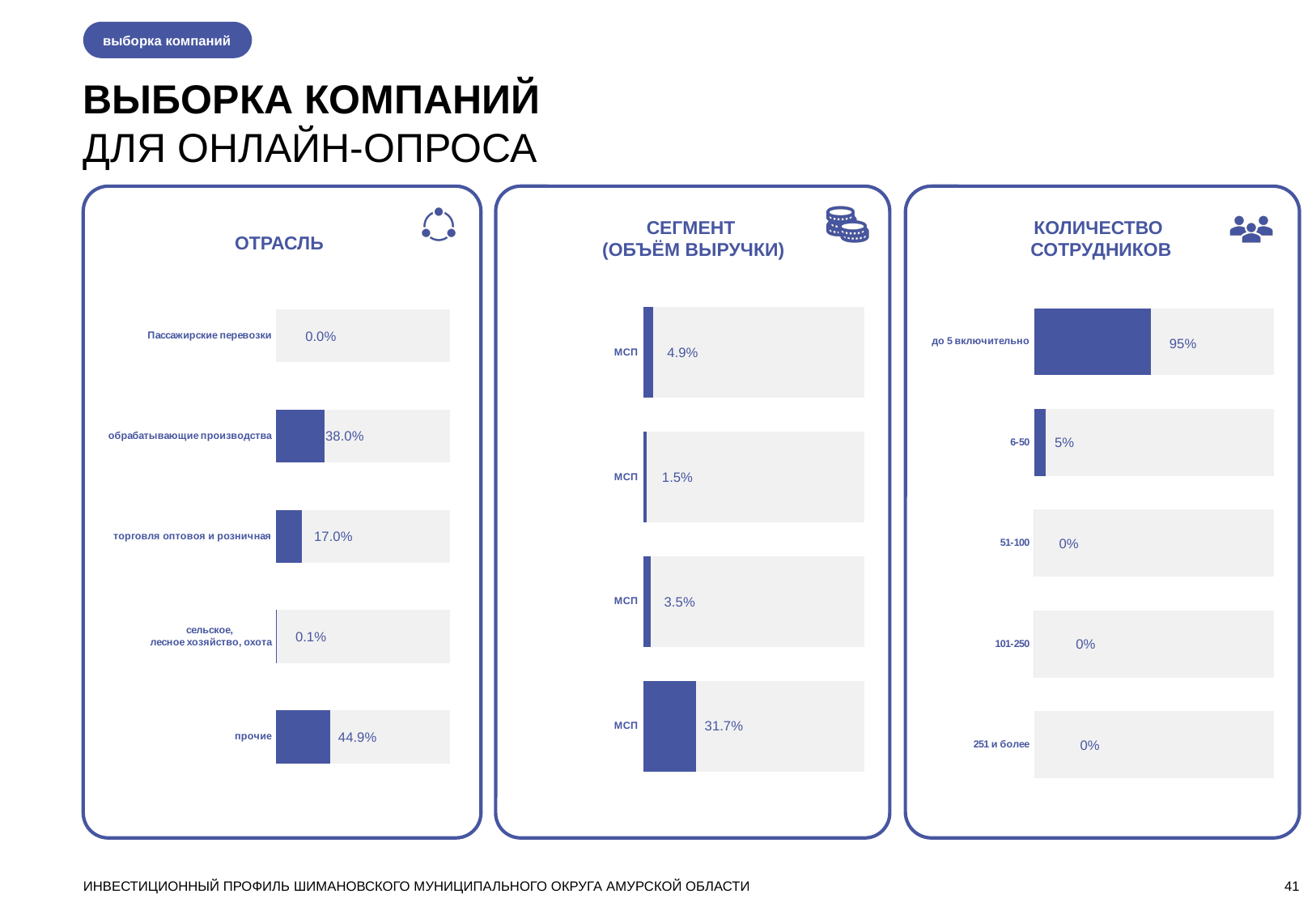
In the "КОЛИЧЕСТВО СОТРУДНИКОВ" chart, what is the value for "до 5 включительно"? 95% What kind of chart is the "КОЛИЧЕСТВО СОТРУДНИКОВ" chart? bar chart In the "СЕГМЕНТ (ОБЪЁМ ВЫРУЧКИ)" chart, what is the value of the bottom bar? 31.7% In the "КОЛИЧЕСТВО СОТРУДНИКОВ" chart, which is larger: the value for "6-50" or the value for "51-100"? 6-50 In the "ОТРАСЛЬ" chart, which category has the highest value? прочие In the "ОТРАСЛЬ" chart, what is the value for "торговля оптовая и розничная"? 17.0% How many bars are shown in the "СЕГМЕНТ (ОБЪЁМ ВЫРУЧКИ)" chart? 4 In the "ОТРАСЛЬ" chart, what is the value for "обрабатывающие производства"? 38.0% In the "СЕГМЕНТ (ОБЪЁМ ВЫРУЧКИ)" chart, what is the smallest value shown? 1.5% In the "ОТРАСЛЬ" chart, what is the difference between the values for "прочие" and "обрабатывающие производства"? 6.9% In the "ОТРАСЛЬ" chart, which category has the lowest value? Пассажирские перевозки How many categories are shown in the "ОТРАСЛЬ" chart? 5